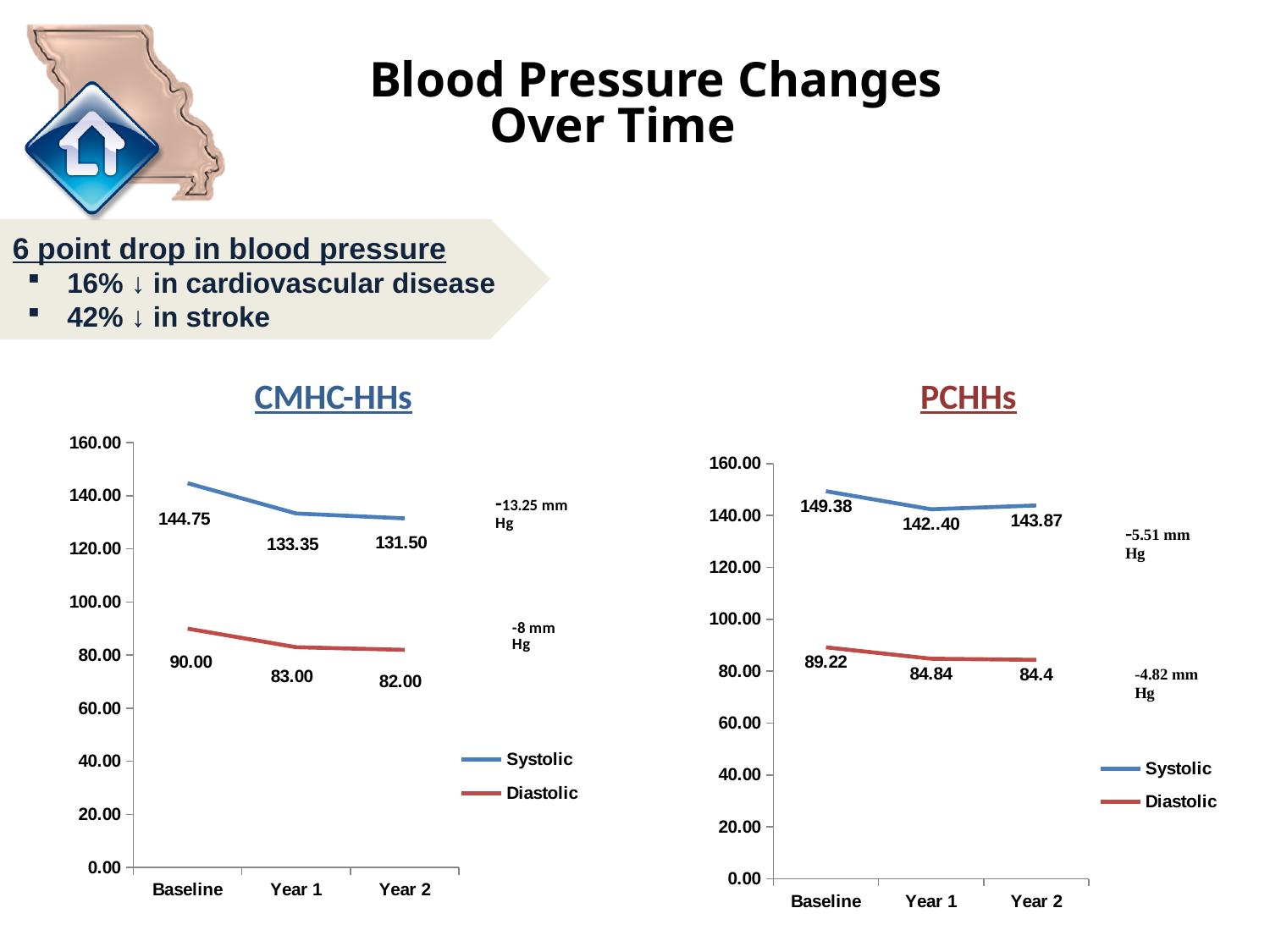
In the PCHHs chart, what is the difference between the Diastolic value at Baseline and at Year 2? 4.82 In the CMHC-HHs chart, what is the Diastolic value at Year 1? 83.00 In the PCHHs chart, at which time point is the Systolic value highest? Baseline What kind of chart is the CMHC-HHs chart? Line chart In the CMHC-HHs chart, does the Systolic value rise or fall from Baseline to Year 2? Fall In the CMHC-HHs chart, what is the Systolic value at Baseline? 144.75 In the PCHHs chart, what is the Systolic value at Year 2? 143.87 How many series does the legend of the PCHHs chart list? 2 In the CMHC-HHs chart, at which time point is the Diastolic value lowest? Year 2 In the PCHHs chart, what is the Diastolic value at Baseline? 89.22 In the CMHC-HHs chart, what is the difference between the Systolic value at Baseline and at Year 2? 13.25 Which is larger: the Systolic value at Baseline in the CMHC-HHs chart or in the PCHHs chart? PCHHs